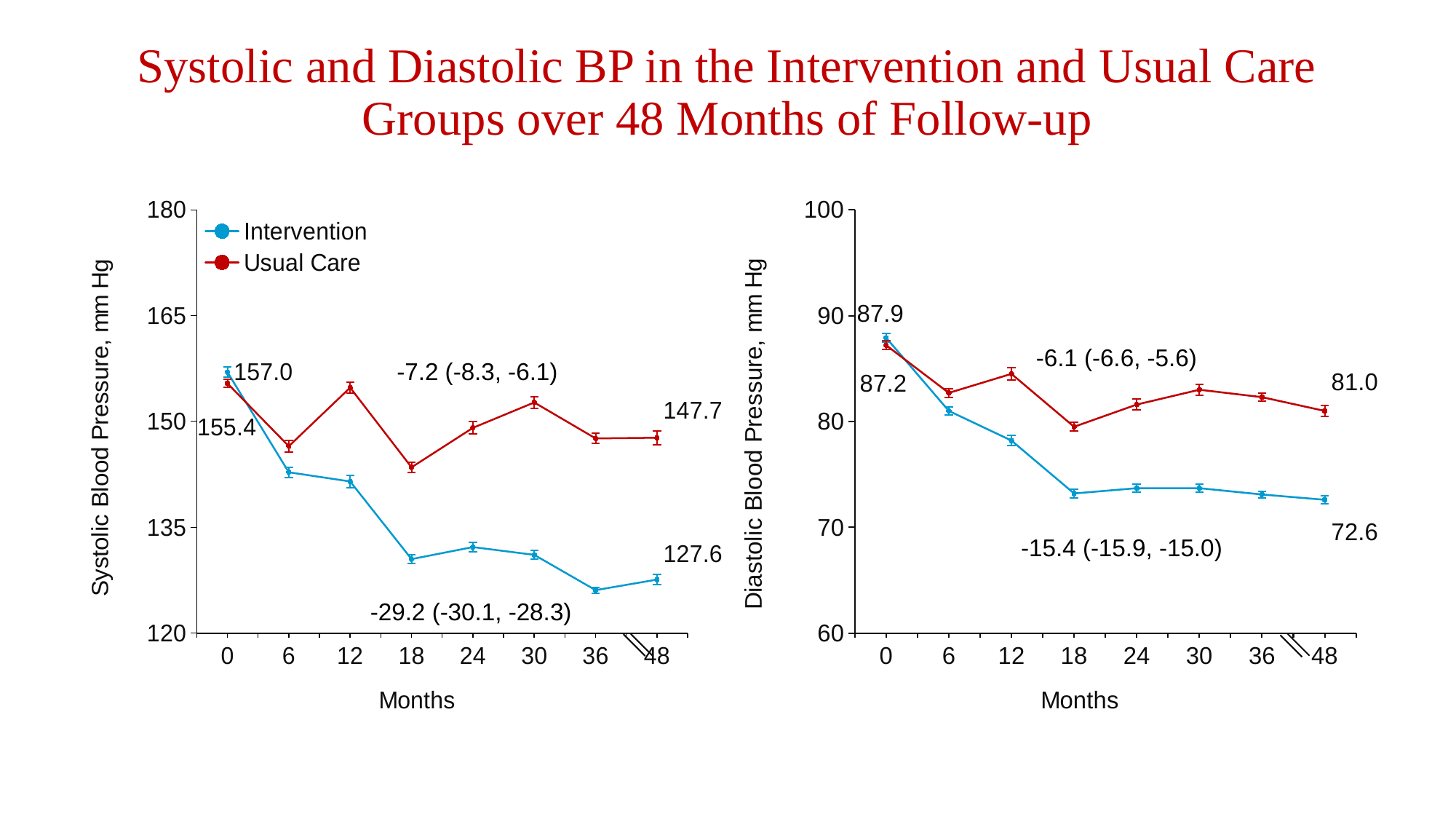
In the Systolic Blood Pressure chart on the left, which group has the higher value at 48 months, Intervention or Usual Care? Usual Care What kind of chart is the Diastolic Blood Pressure chart on the right? Line chart How many time points are plotted along the x axis of the Systolic Blood Pressure chart on the left? 8 How many series does the legend of the Systolic Blood Pressure chart on the left list? 2 In the Systolic Blood Pressure chart on the left, what is the Intervention value at 0 months? 157.0 In the Systolic Blood Pressure chart on the left, what is the difference between the Usual Care and Intervention values at 48 months? 20.1 In the Systolic Blood Pressure chart on the left, is the Intervention value at 36 months greater or less than 135? less In the Systolic Blood Pressure chart on the left, what is the Usual Care value at 48 months? 147.7 In the Diastolic Blood Pressure chart on the right, is the Usual Care value at 12 months greater or less than 80? greater In the Diastolic Blood Pressure chart on the right, what is the difference between the Usual Care and Intervention values at 48 months? 8.4 In the Diastolic Blood Pressure chart on the right, what is the Intervention value at 48 months? 72.6 In the Diastolic Blood Pressure chart on the right, what is the Usual Care value at 0 months? 87.2